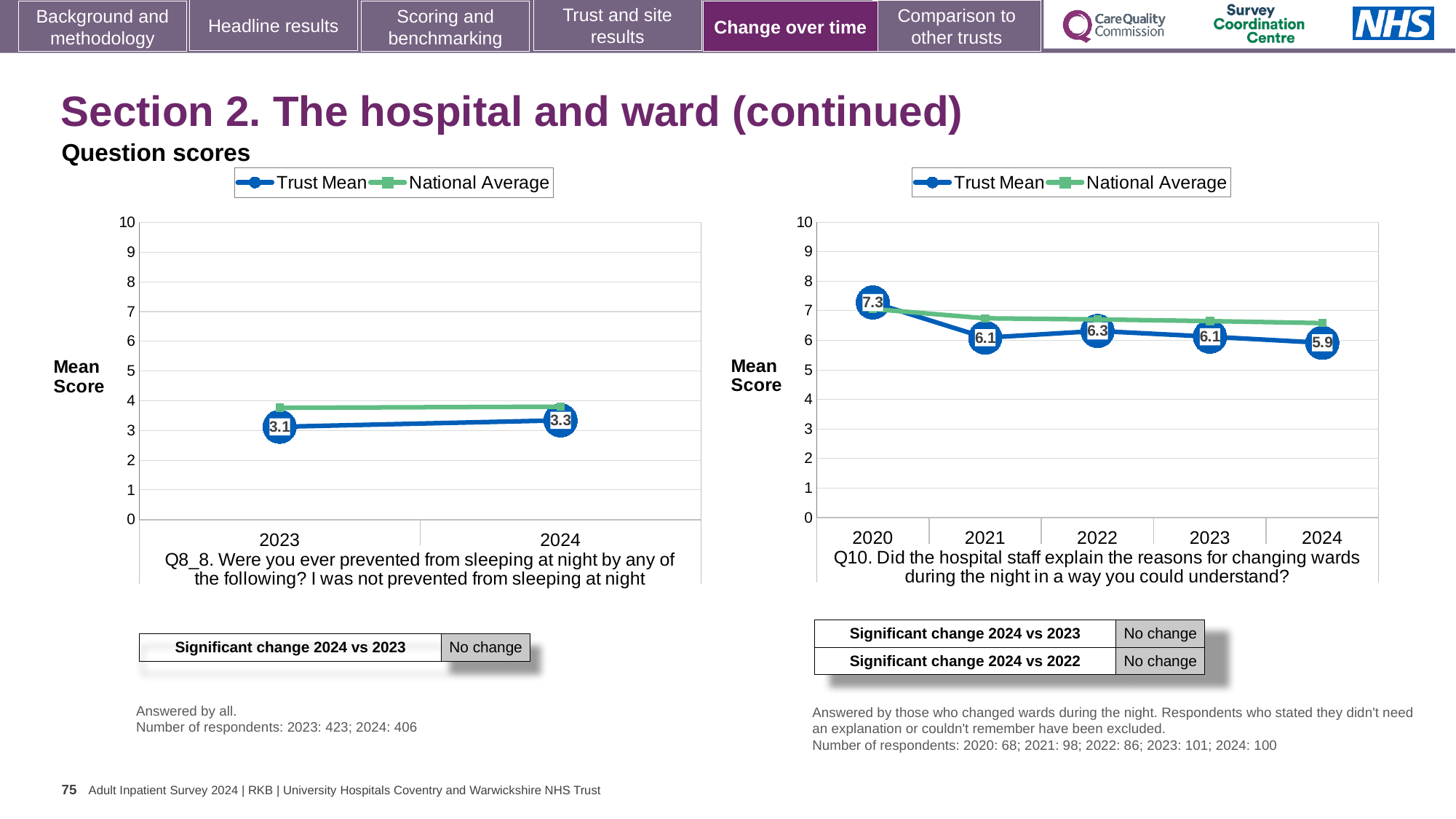
In the Q10 chart on the right, which year has the highest Trust Mean score? 2020 What type of chart is used for the Q8_8 question on the left? Line chart In the Q8_8 chart on the left, what is the Trust Mean score for 2024? 3.3 In the Q8_8 chart on the left, is the National Average for 2024 greater or less than 3? greater In the Q10 chart on the right, what is the difference between the Trust Mean in 2020 and in 2024? 1.4 In the Q10 chart on the right, is the Trust Mean for 2024 higher or lower than the National Average for 2024? lower In the Q10 chart on the right, what is the Trust Mean score for 2024? 5.9 In the Q8_8 chart on the left, what is the Trust Mean score for 2023? 3.1 In the Q10 chart on the right, which year has the lowest Trust Mean score? 2024 In the Q10 chart on the right, what is the Trust Mean score for 2020? 7.3 In the Q10 chart on the right, how many years are plotted on the x axis? 5 In the Q8_8 chart on the left, by how much did the Trust Mean change from 2023 to 2024? 0.2